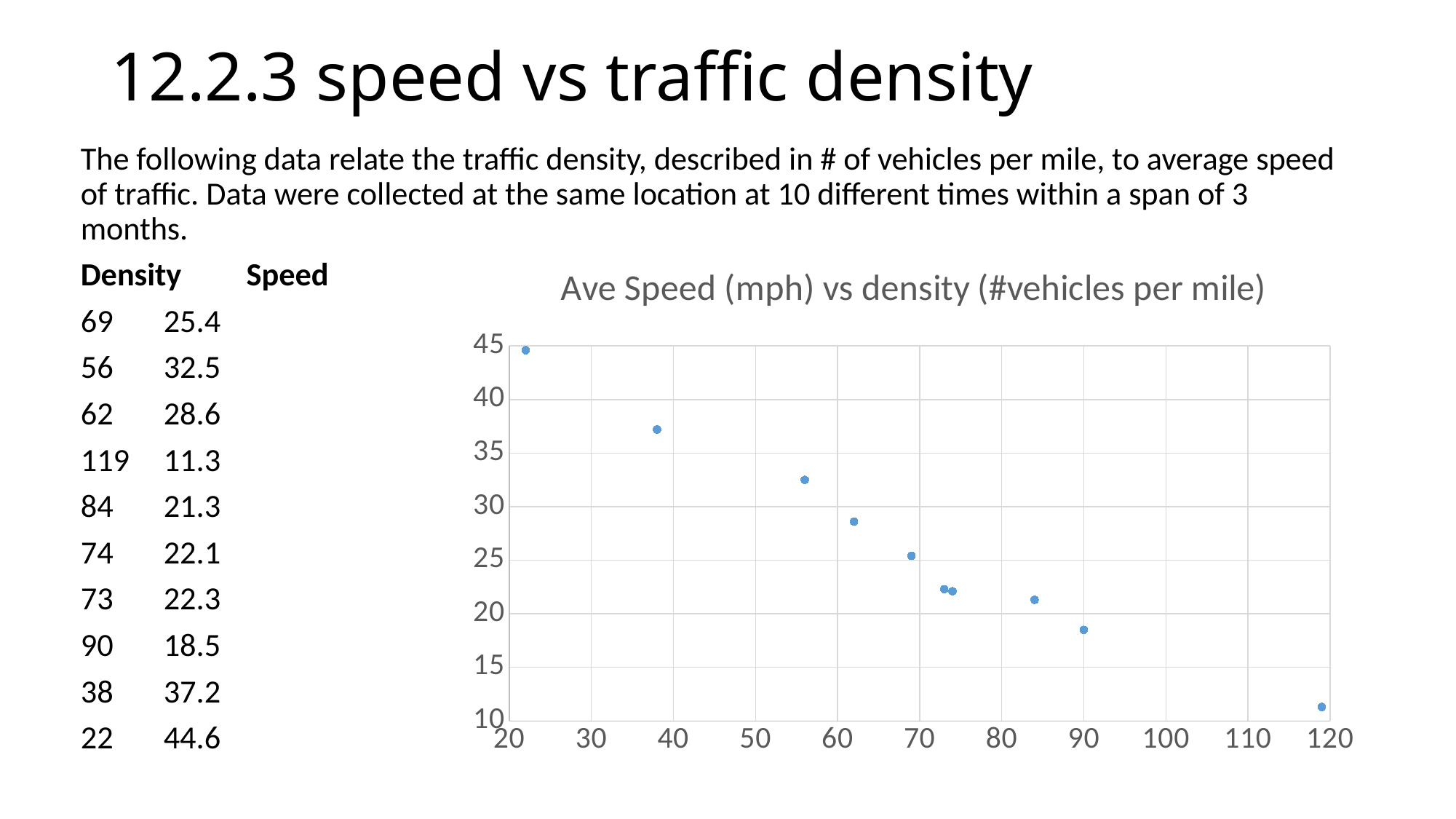
As density increases along the x axis, does average speed rise or fall? fall Is the average speed at density 69 greater or less than 30? less What is the average speed at a density of 119 vehicles per mile? 11.3 Which density has the lowest average speed? 119 What is the average speed at a density of 90 vehicles per mile? 18.5 Which density has the highest average speed? 22 How many data points are plotted on the chart? 10 What kind of chart is shown on the slide? scatter chart What is the title of the chart? Ave Speed (mph) vs density (#vehicles per mile) What is the difference in average speed between density 38 and density 84? 15.9 What is the average speed at a density of 22 vehicles per mile? 44.6 Which has a higher average speed, density 56 or density 62? 56